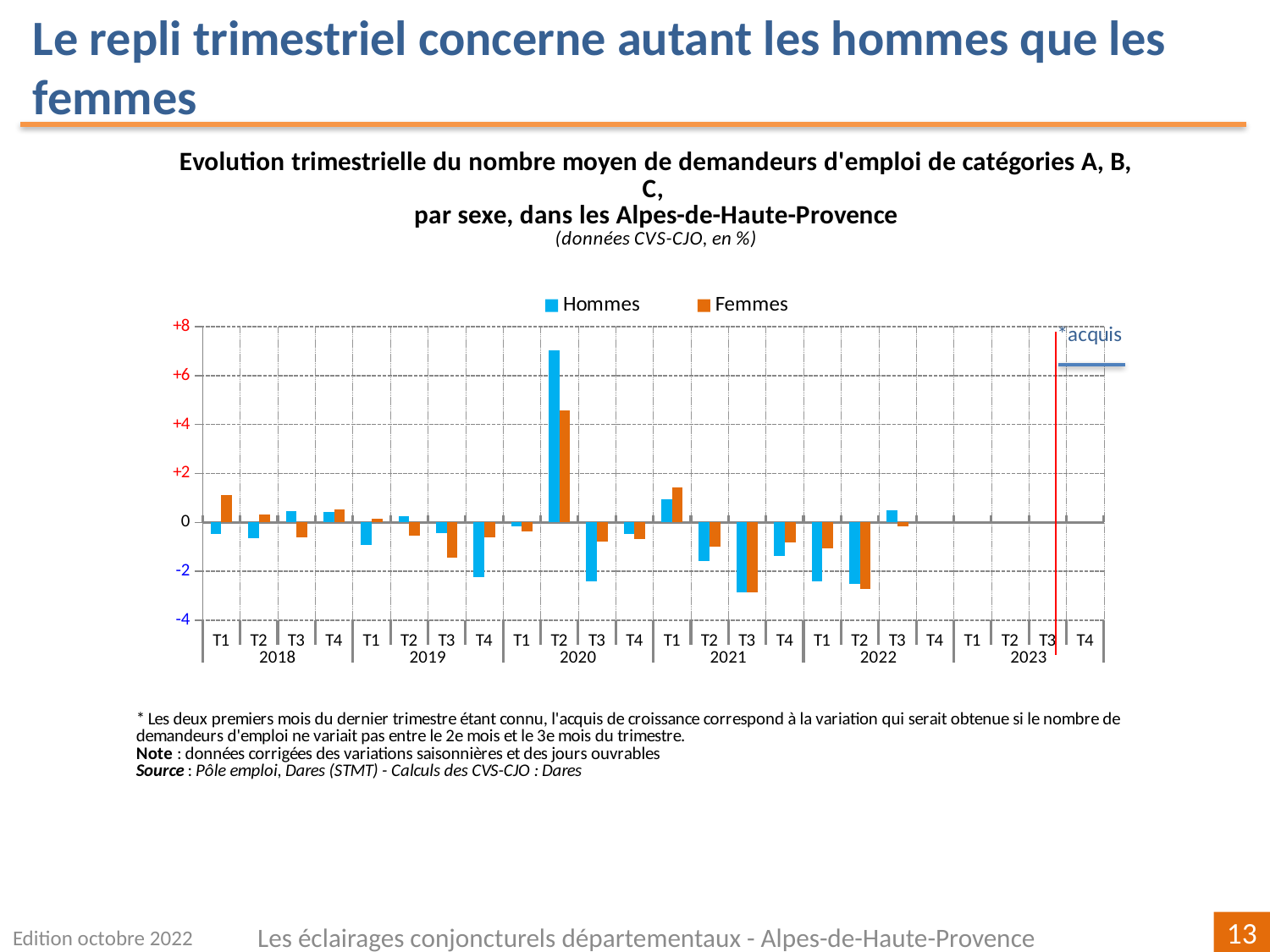
Is the Hommes value for T2 2020 greater or less than +6? greater In T2 2020, which series has the larger value, Hommes or Femmes? Hommes How many series does the legend list? 2 In T1 2018, which series has the larger value, Hommes or Femmes? Femmes What kind of chart is shown on the slide? bar chart In which quarter does the Femmes series reach its highest value? T2 2020 Is the Femmes value for T2 2020 greater or less than +4? greater What are the two series named in the legend? Hommes and Femmes In which quarter does the Hommes series reach its highest value? T2 2020 Which colour represents the Femmes series? orange Is the Hommes value for T3 2021 greater or less than -2? less